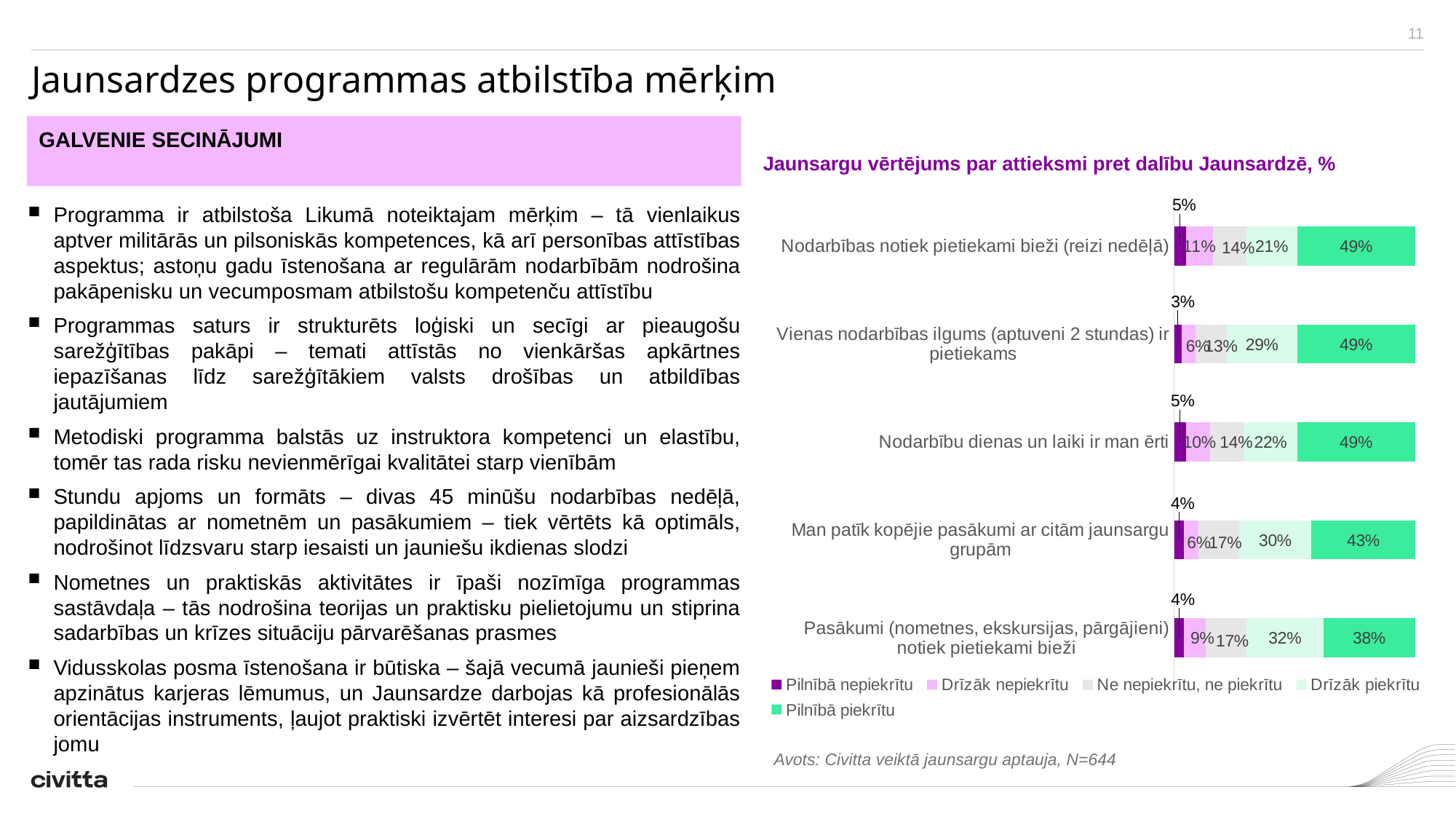
What is the title of the chart? Jaunsargu vērtējums par attieksmi pret dalību Jaunsardzē, % What is the total of the stacked bar for "Nodarbību dienas un laiki ir man ērti"? 100% What percentage of respondents fully agree (Pilnībā piekrītu) that "Nodarbības notiek pietiekami bieži (reizi nedēļā)"? 49% How many series does the legend list? 5 What is the "Pilnībā nepiekrītu" value for "Vienas nodarbības ilgums (aptuveni 2 stundas) ir pietiekams"? 3% Which statement has the lowest "Pilnībā piekrītu" share? Pasākumi (nometnes, ekskursijas, pārgājieni) notiek pietiekami bieži What is the "Drīzāk piekrītu" value for "Pasākumi (nometnes, ekskursijas, pārgājieni) notiek pietiekami bieži"? 32% What kind of chart is shown on the slide? Stacked bar chart Which statement has the highest "Drīzāk nepiekrītu" share? Nodarbības notiek pietiekami bieži (reizi nedēļā) How many statements (categories) are shown in the chart? 5 What is the difference between the "Pilnībā piekrītu" values for "Man patīk kopējie pasākumi ar citām jaunsargu grupām" and "Pasākumi (nometnes, ekskursijas, pārgājieni) notiek pietiekami bieži"? 5% Which is larger: the "Drīzāk piekrītu" value for "Nodarbību dienas un laiki ir man ērti" or for "Vienas nodarbības ilgums (aptuveni 2 stundas) ir pietiekams"? Vienas nodarbības ilgums (aptuveni 2 stundas) ir pietiekams